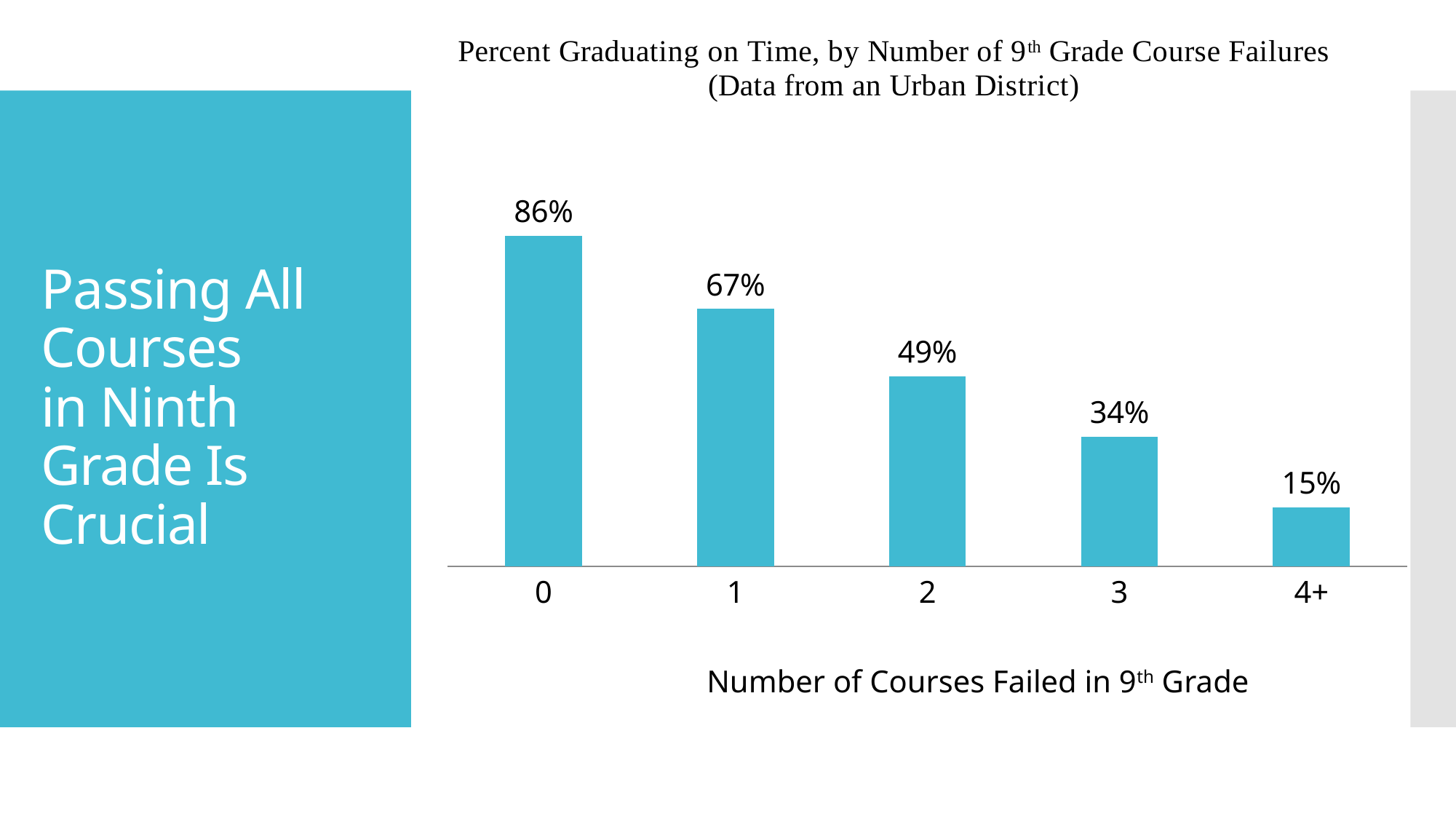
What is the difference in percent graduating on time between students with 0 failures and students with 1 failure? 19% How many categories of course failures are shown on the x axis? 5 Does the percent graduating on time rise or fall as the number of courses failed increases? Fall Which number of course failures has the lowest percent graduating on time? 4+ What is the percent graduating on time for students who failed 2 courses in 9th grade? 49% What percent of students with 0 ninth-grade course failures graduated on time? 86% What is the percent graduating on time for the 4+ course failures category? 15% Which has a higher percent graduating on time: 1 course failure or 3 course failures? 1 What is the label of the x axis of the chart? Number of Courses Failed in 9th Grade What kind of chart is shown on the slide? Bar chart What is the difference in percent graduating on time between students with 3 failures and students with 4+ failures? 19% Which number of course failures has the highest percent graduating on time? 0